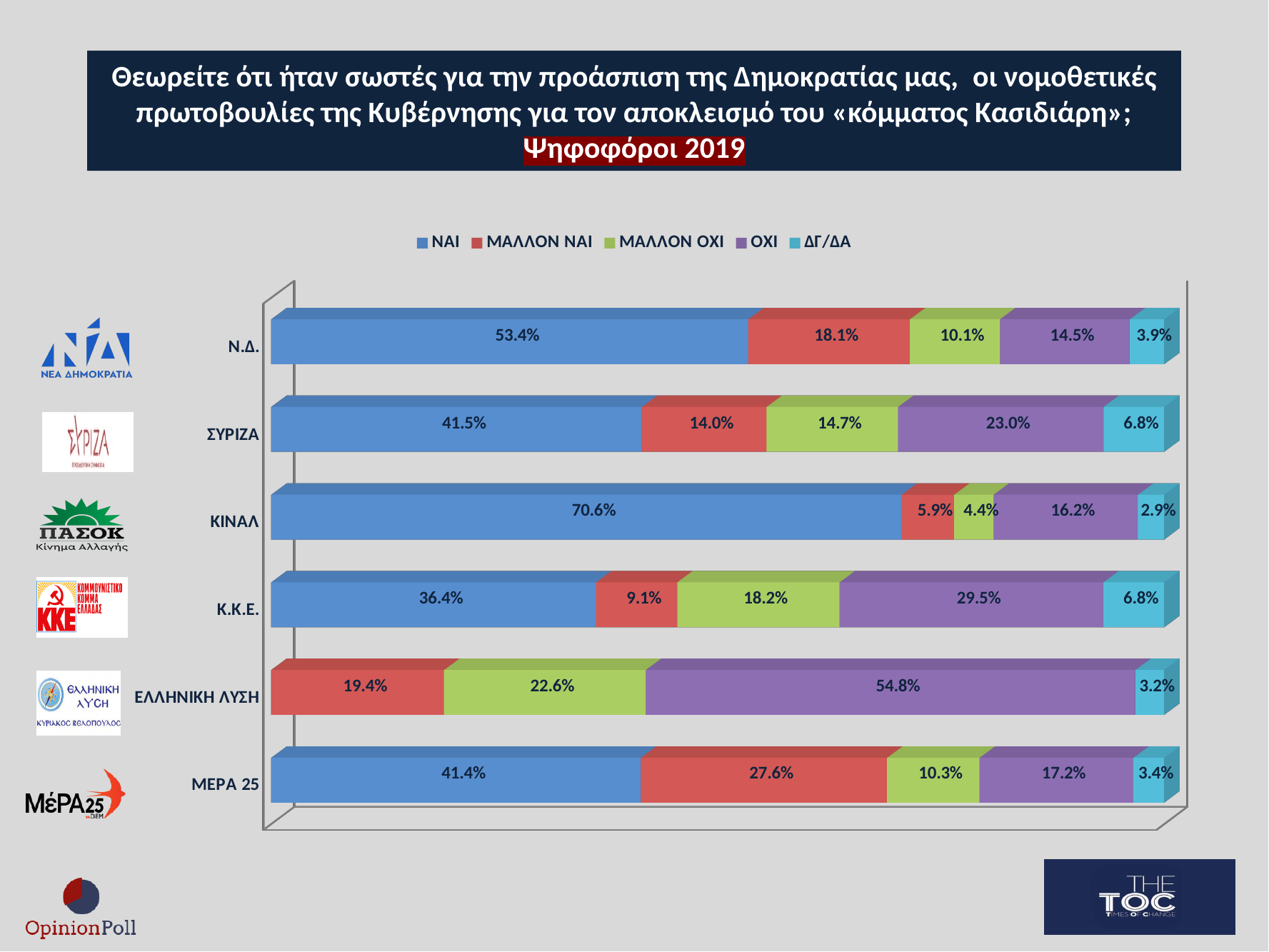
Which party's bar has no ΝΑΙ segment? ΕΛΛΗΝΙΚΗ ΛΥΣΗ Which party has the lowest ΔΓ/ΔΑ value? ΚΙΝΑΛ What is the ΜΑΛΛΟΝ ΝΑΙ value for ΜΕΡΑ 25? 27.6% How many series does the legend list? 5 What type of chart is shown on the slide? stacked bar chart Which is larger, the ΟΧΙ value for Κ.Κ.Ε. or the ΟΧΙ value for ΣΥΡΙΖΑ? Κ.Κ.Ε. What is the difference between the ΝΑΙ values for Ν.Δ. and ΣΥΡΙΖΑ? 11.9% How many party categories are shown on the chart? 6 Which party has the highest ΝΑΙ value? ΚΙΝΑΛ What is the total of the ΜΑΛΛΟΝ ΟΧΙ and ΟΧΙ values for Κ.Κ.Ε.? 47.7% What is the ΝΑΙ value for ΚΙΝΑΛ? 70.6% What is the ΟΧΙ value for ΕΛΛΗΝΙΚΗ ΛΥΣΗ? 54.8%